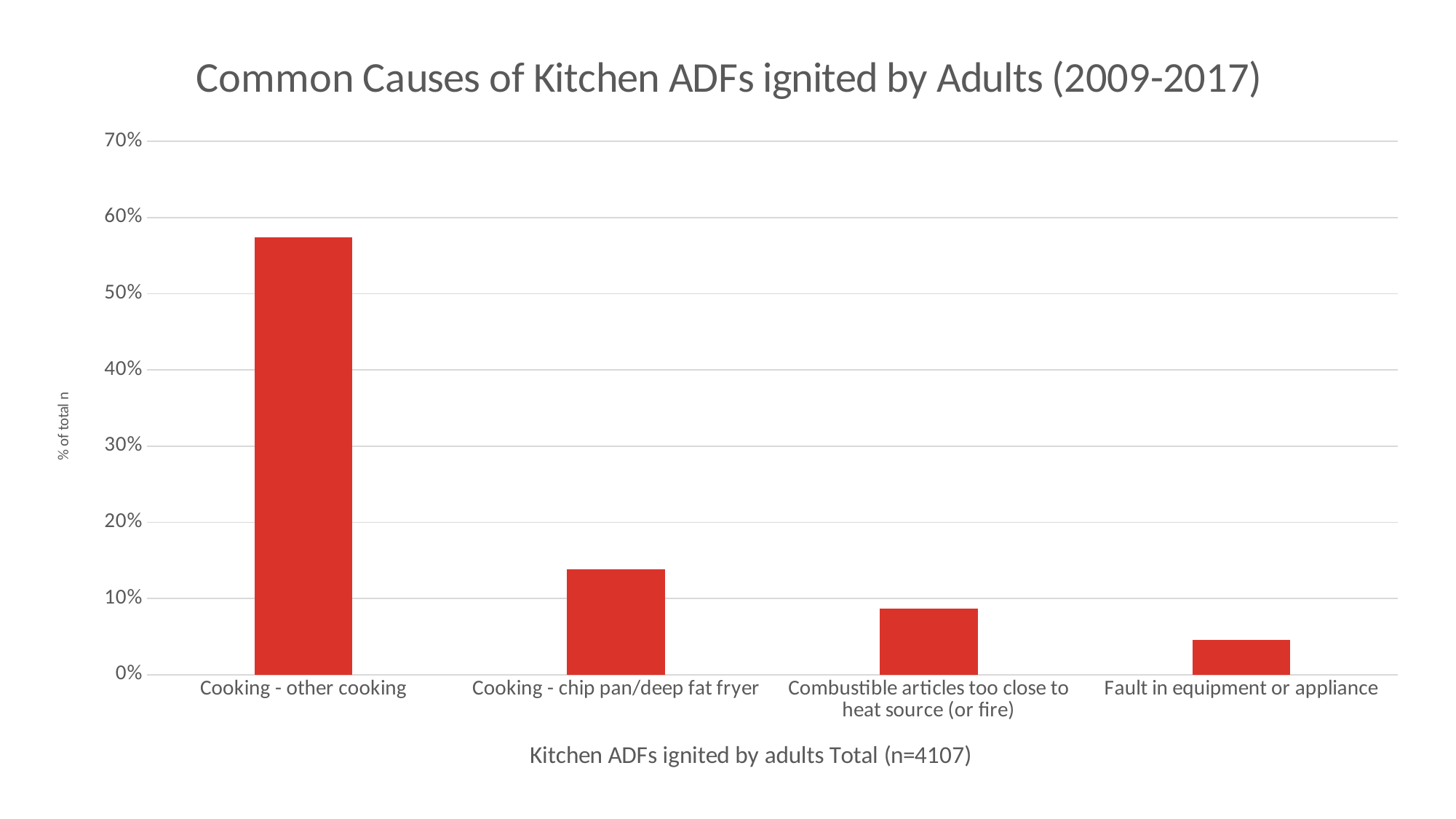
What kind of chart is shown on the slide? bar chart What is the x axis title of the chart? Kitchen ADFs ignited by adults Total (n=4107) Is the value for Combustible articles too close to heat source (or fire) greater or less than 10%? less How many categories are shown on the x axis? 4 Is the value for Cooking - chip pan/deep fat fryer greater or less than 20%? less Is the value for Cooking - other cooking greater or less than 50%? greater Which category has the highest value? Cooking - other cooking What is the title of the chart? Common Causes of Kitchen ADFs ignited by Adults (2009-2017) Do the values rise or fall from left to right along the x axis? fall Which category has the lowest value? Fault in equipment or appliance Which is larger: the value for Cooking - chip pan/deep fat fryer or the value for Combustible articles too close to heat source (or fire)? Cooking - chip pan/deep fat fryer